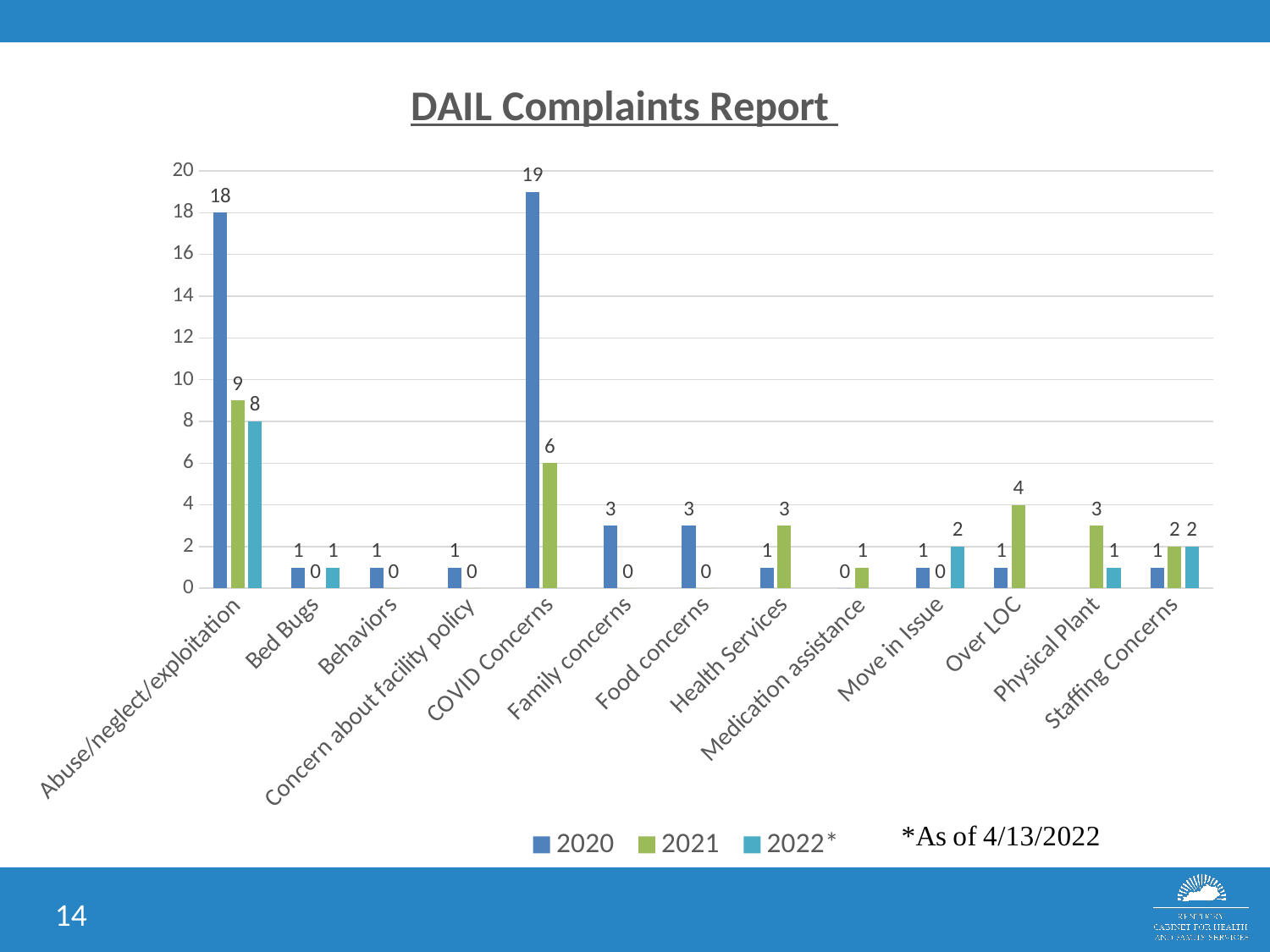
What is the 2021 value for Abuse/neglect/exploitation? 9 Which is larger for Health Services, the 2020 value or the 2021 value? 2021 What is the 2021 value for Over LOC? 4 How many categories are shown on the x axis? 13 What kind of chart is shown on the slide? Bar chart What is the 2020 value for COVID Concerns? 19 What is the 2022* value for Move in Issue? 2 How many series does the legend list? 3 Which category has the highest 2020 value? COVID Concerns What is the difference between the 2020 and 2021 values for COVID Concerns? 13 Which category has the highest 2021 value? Abuse/neglect/exploitation What is the title of the chart? DAIL Complaints Report